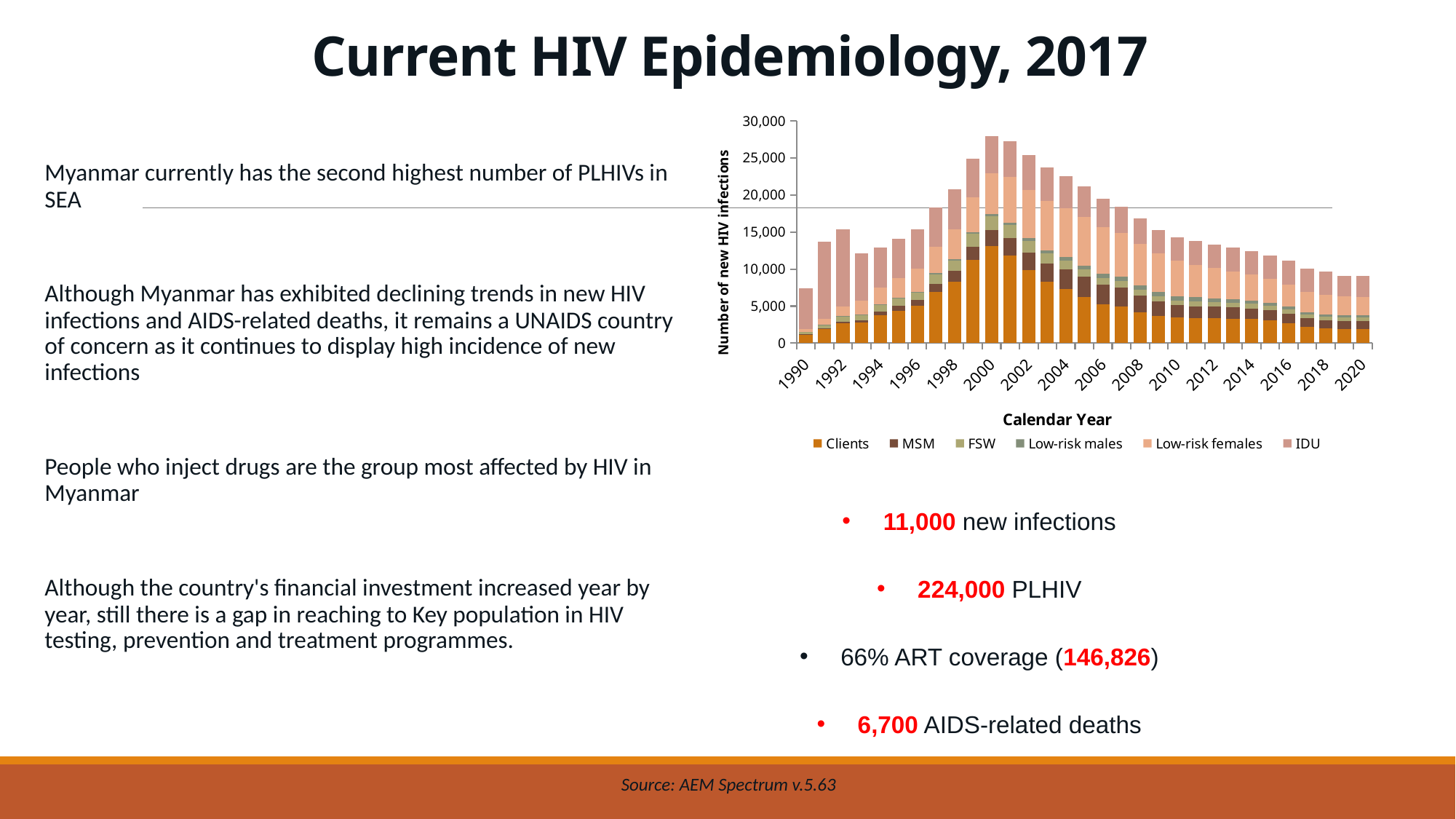
Which year has the lowest total number of new HIV infections in the chart? 1990 Is the total number of new HIV infections in 2000 greater or less than 25,000? greater How many series does the chart's legend list? 6 What is the title of the chart's vertical axis? Number of new HIV infections Do the total new HIV infections rise or fall from 2000 to 2020? Fall Is the total number of new HIV infections in 1990 greater or less than 10,000? less How many year labels are shown on the chart's x axis? 16 Is the total number of new HIV infections in 2020 greater or less than 10,000? less Which year has the highest total number of new HIV infections in the chart? 2000 What is the title of the chart's horizontal axis? Calendar Year Which year has a larger total of new HIV infections, 2000 or 2010? 2000 What kind of chart is shown on the slide? Stacked bar chart